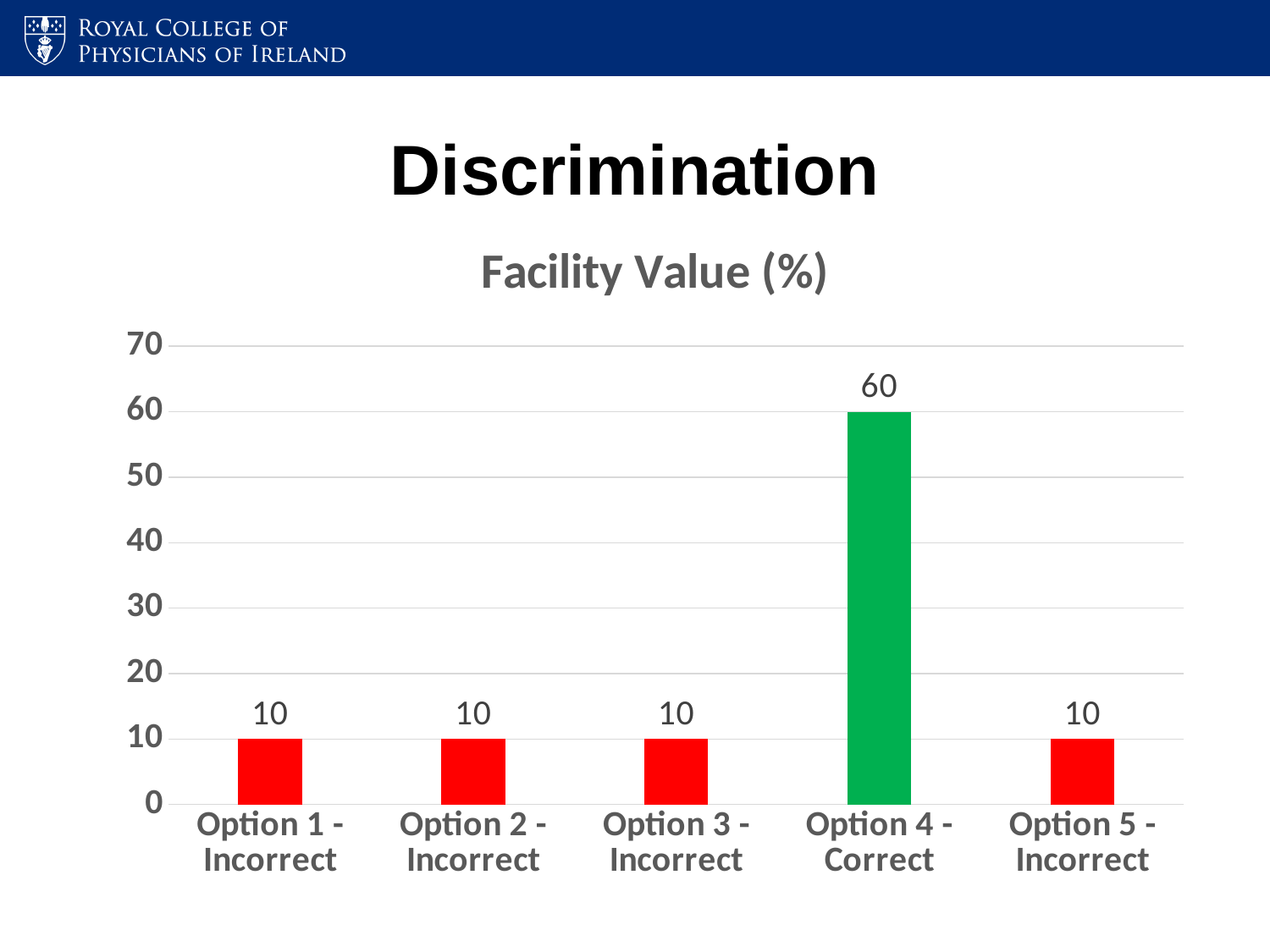
What is the value for Option 5 - Incorrect? 10 Which category has the highest value? Option 4 - Correct What is the title of the chart? Facility Value (%) What kind of chart is shown on the slide? bar chart What is the value for Option 1 - Incorrect? 10 Is the value for Option 4 - Correct greater or less than 50? greater Is the value for Option 2 - Incorrect greater or less than 20? less How many categories are shown on the x axis? 5 What colour is the bar for Option 4 - Correct? green What is the difference between the values for Option 4 - Correct and Option 2 - Incorrect? 50 What is the value for Option 4 - Correct? 60 Which is larger, the value for Option 3 - Incorrect or the value for Option 4 - Correct? Option 4 - Correct